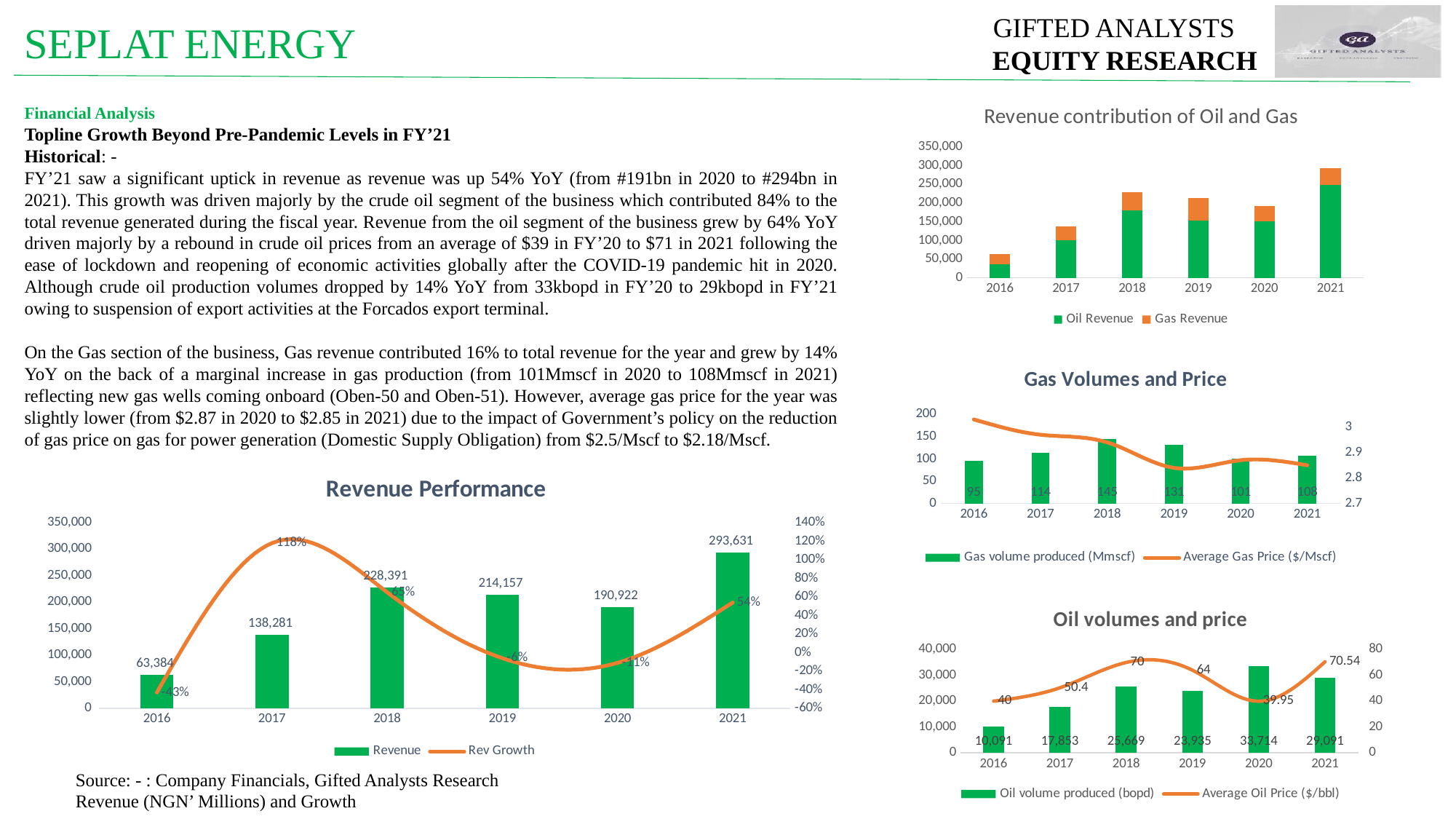
In the Oil volumes and price chart, what is the average oil price for 2021? 70.54 In the Revenue Performance chart, what is the difference between the revenue in 2018 and the revenue in 2019? 14,234 In the Oil volumes and price chart, what is the oil volume produced in 2020? 33,714 In the Gas Volumes and Price chart, which year has the lowest gas volume produced? 2016 In the Revenue contribution of Oil and Gas chart, is the total bar for 2021 greater or less than 250,000? greater In the Gas Volumes and Price chart, what is the gas volume produced in 2018? 145 In the Oil volumes and price chart, is the oil volume produced in 2019 larger than in 2020? No In the Revenue Performance chart, which year has the lowest revenue? 2016 In the Revenue Performance chart, what is the Rev Growth value for 2016? -43% How many series does the legend of the Revenue contribution of Oil and Gas chart list? 2 In the Revenue Performance chart, what is the revenue value for 2021? 293,631 In the Revenue Performance chart, what is the Rev Growth value for 2017? 118%